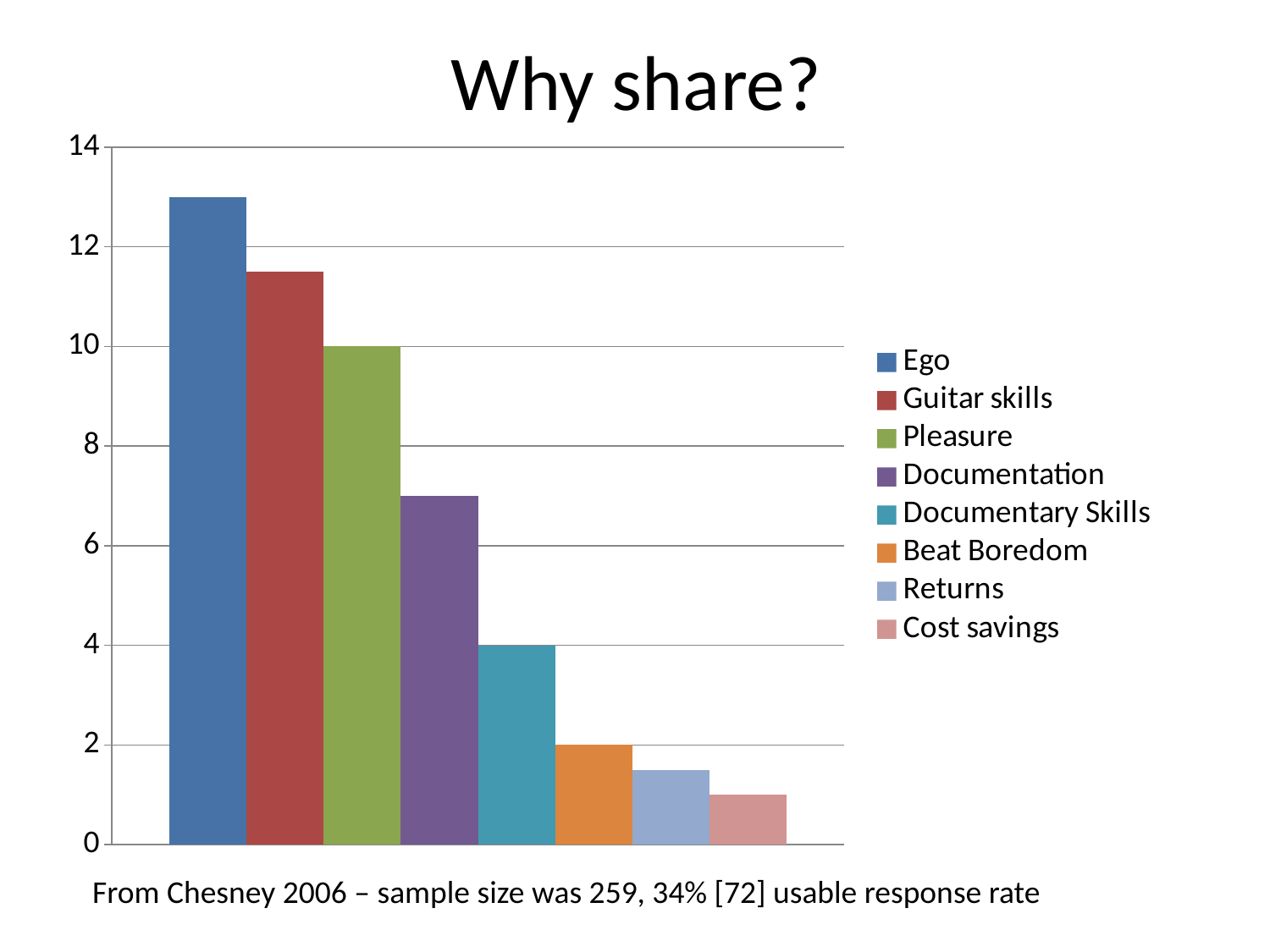
Which category has the highest value? Ego What type of chart is shown on the slide? bar chart Is the value for Ego greater or less than 12? greater What is the value for Documentary Skills? 4 Which category has the lowest value? Cost savings What is the value for Beat Boredom? 2 Is the value for Documentation greater or less than 8? less What is the title of the chart? Why share? What is the value for Pleasure? 10 How many bars are plotted in the chart? 8 How many entries does the legend list? 8 What is the difference between the values for Pleasure and Documentary Skills? 6